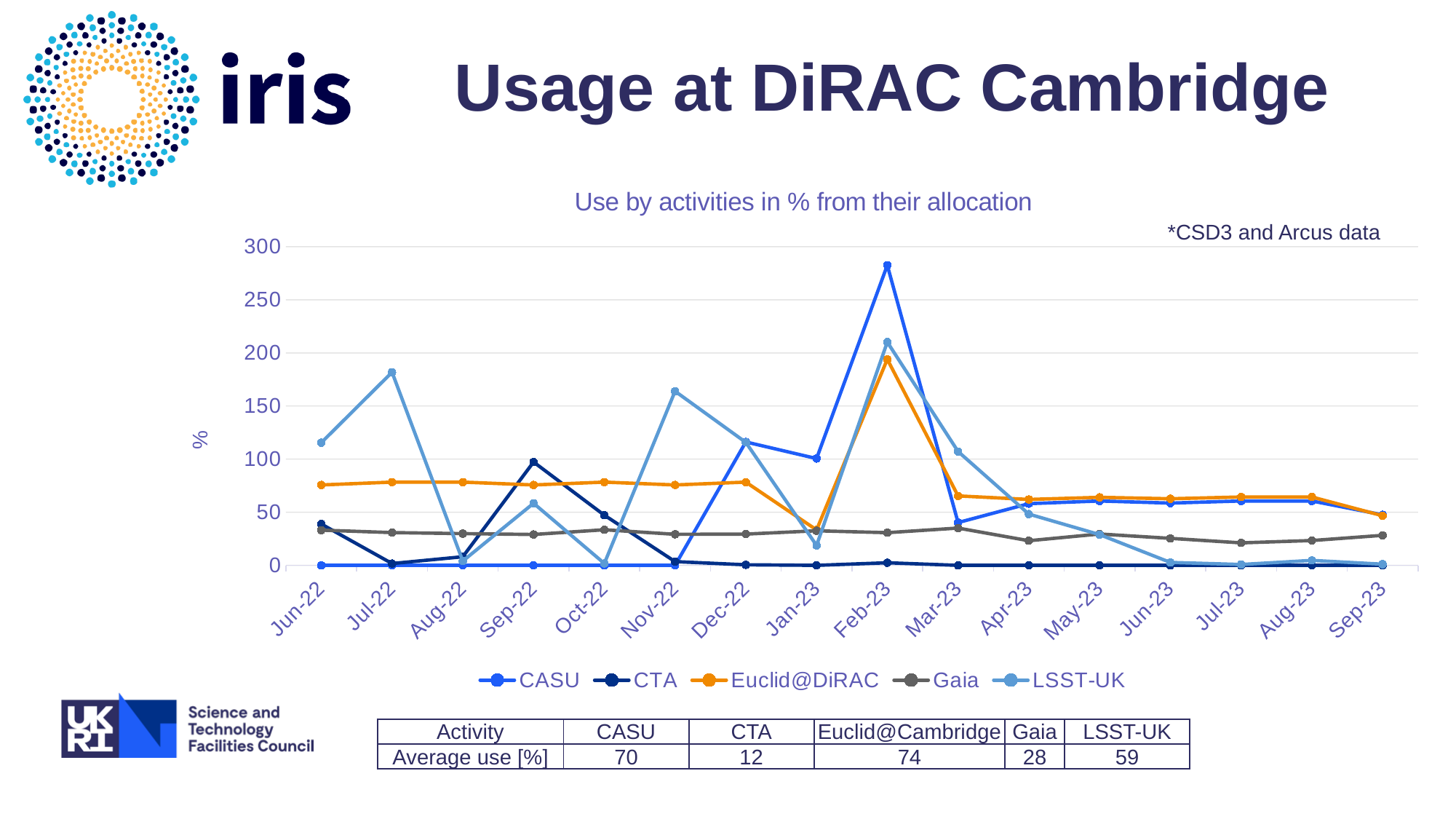
What is the title of the chart? Use by activities in % from their allocation Is the value for Euclid@DiRAC in Jun-22 greater or less than 100? less In Sep-22, which is larger: the value for CTA or the value for LSST-UK? CTA According to the table below the chart, what is the average use [%] for Euclid@Cambridge? 74 How many months are shown along the x axis of the chart? 16 Which series reaches the highest value in Feb-23? CASU Does the Euclid@DiRAC line rise or fall from Feb-23 to Mar-23? fall Is the value for LSST-UK in Jul-22 greater or less than 150? greater How many series does the chart legend list? 5 What kind of chart is shown on the slide? line chart In which month does CASU reach its highest value? Feb-23 Is the value for CASU in Feb-23 greater or less than 250? greater